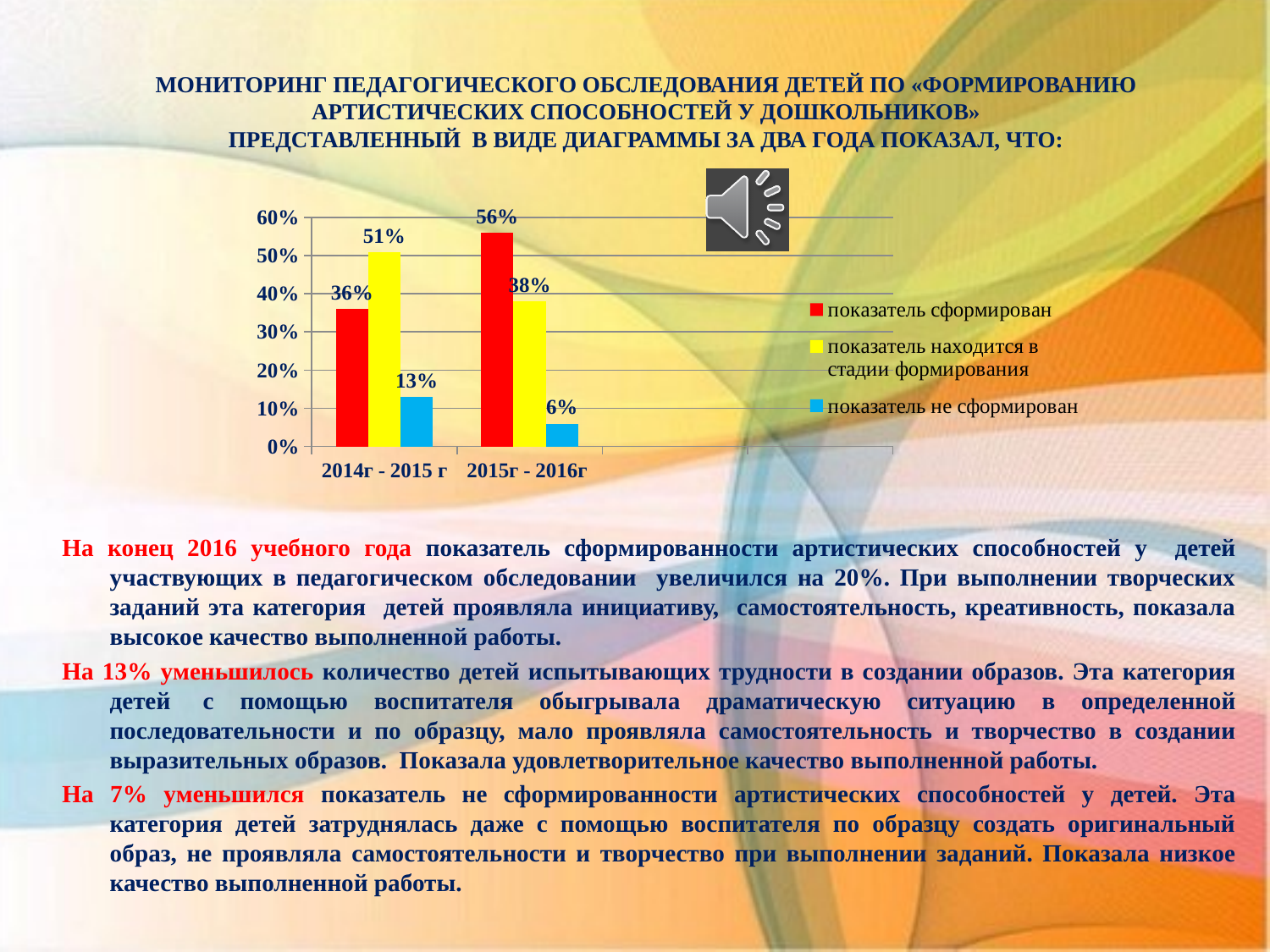
What is the value of «показатель сформирован» for 2014г - 2015 г? 36% How many categories (periods) are shown on the x axis? 2 What is the value of «показатель находится в стадии формирования» for 2014г - 2015 г? 51% How many series does the legend list? 3 What type of chart is shown on the slide? bar chart What is the value of «показатель сформирован» for 2015г - 2016г? 56% Which series has the lowest value in 2014г - 2015 г? показатель не сформирован Which is larger: «показатель находится в стадии формирования» in 2014г - 2015 г or in 2015г - 2016г? 2014г - 2015 г What is the value of «показатель не сформирован» for 2015г - 2016г? 6% Which series has the highest value in 2015г - 2016г? показатель сформирован By how much did «показатель сформирован» change from 2014г - 2015 г to 2015г - 2016г? 20% Does «показатель не сформирован» rise or fall from 2014г - 2015 г to 2015г - 2016г? fall